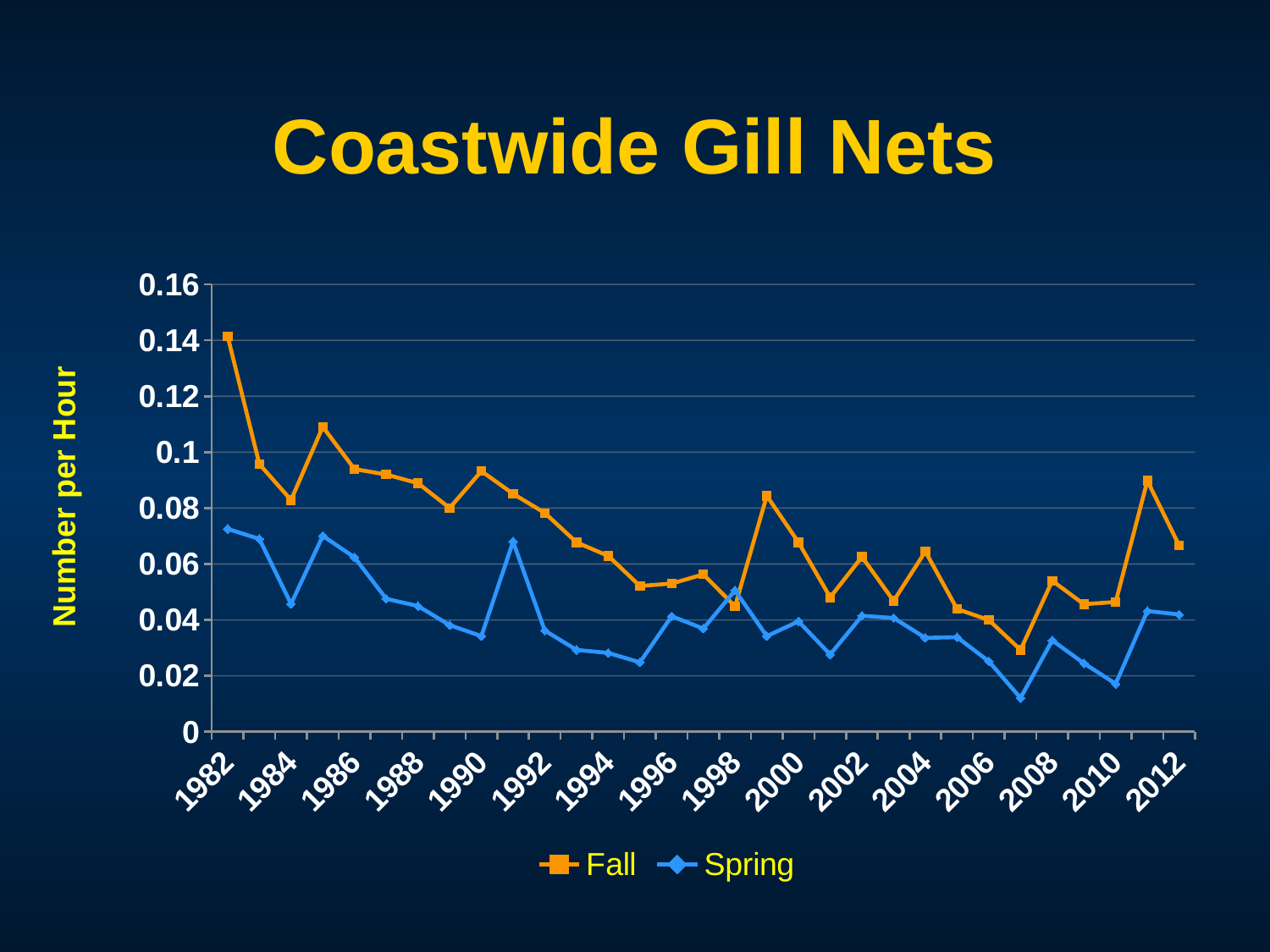
What is the title of the chart? Coastwide Gill Nets What is the label on the vertical axis? Number per Hour In which year is the Fall series at its highest? 1982 Is the Fall value for 1982 greater or less than 0.12? greater Is the Fall value for 2011 greater or less than 0.08? greater Which series has the larger value in 1982, Fall or Spring? Fall Does the Fall series rise or fall from 1982 to 1984? fall In which year is the Fall series at its lowest? 2007 Is the Spring value for 2007 greater or less than 0.02? less What kind of chart is shown on the slide? line chart In which year is the Spring series at its lowest? 2007 How many series does the legend list? 2